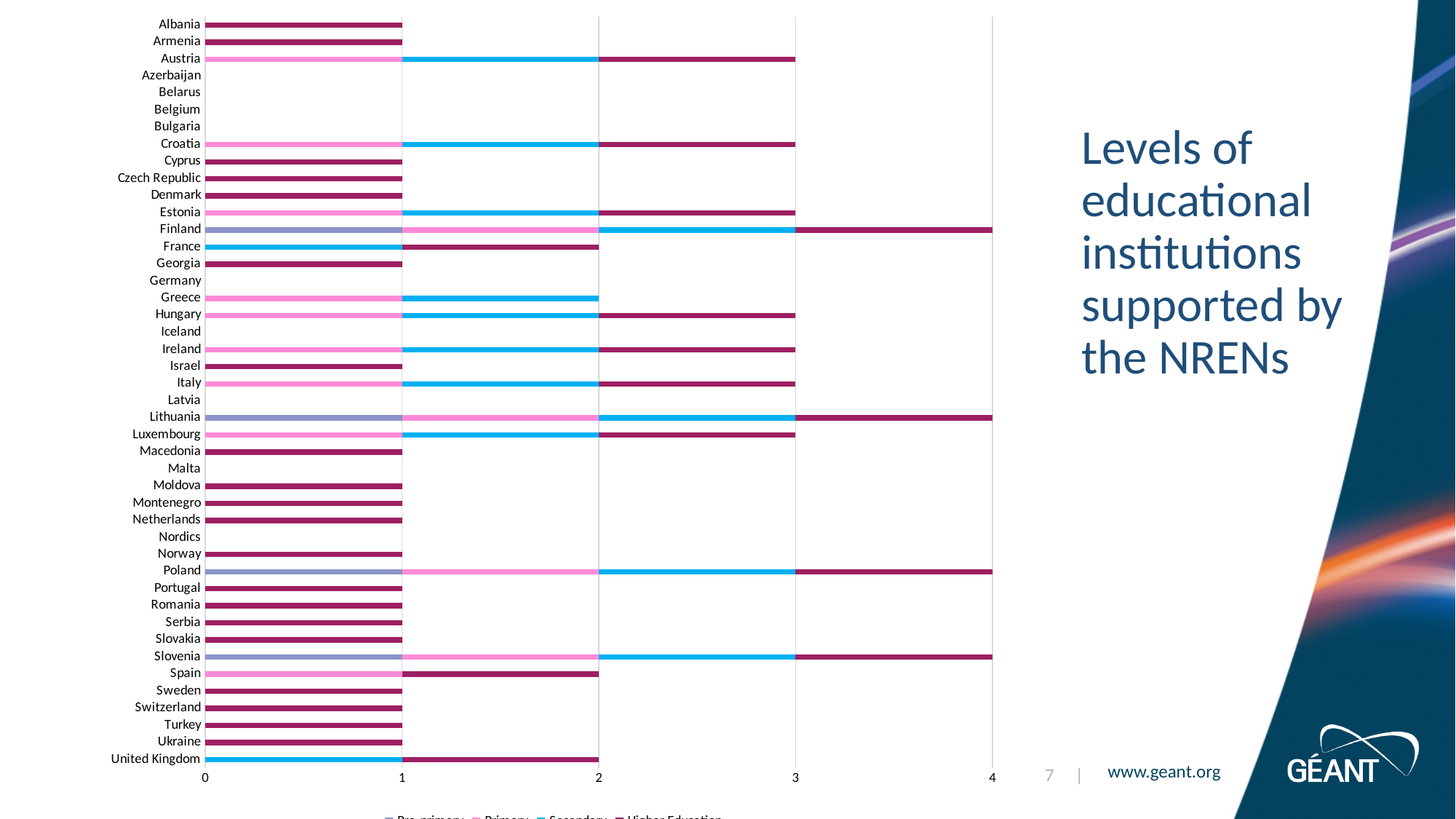
What is the total length of the stacked bar for Finland? 4 What kind of chart is shown on the slide? Bar chart What is the total bar length for Albania? 1 How many countries have stacked bars reaching 4 on the axis? 4 How many countries or regions are listed on the vertical axis of the chart? 44 What is the difference between the total bar for Finland and the total bar for Greece? 2 What is the total length of the stacked bar for the United Kingdom? 2 What is the title of the slide's chart? Levels of educational institutions supported by the NRENs What is the highest value shown on the horizontal axis? 4 Which has the longer total bar, Greece or Italy? Italy Is the total bar for Spain greater or less than 3? less